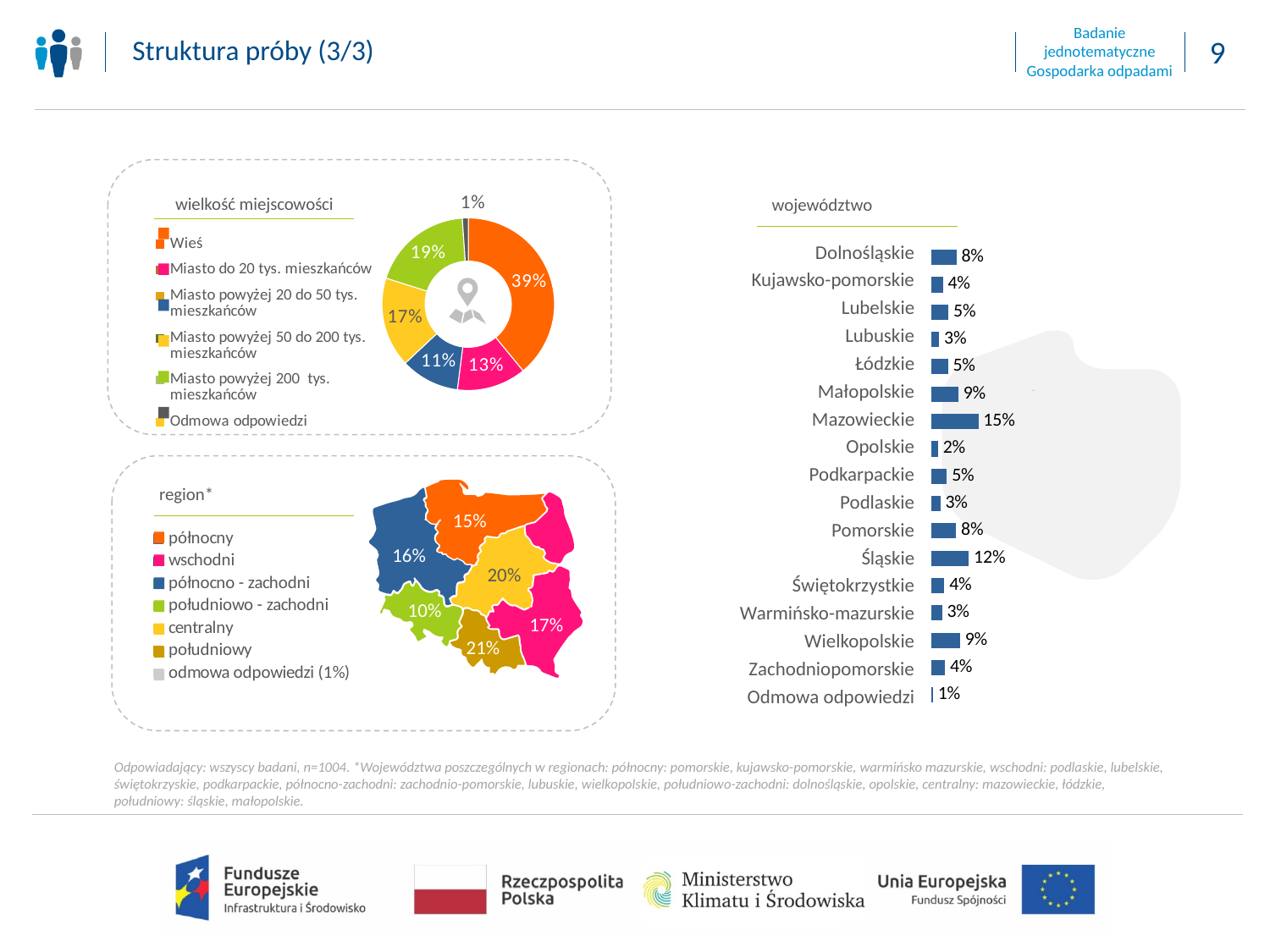
In the 'wielkość miejscowości' donut chart, what share is shown for 'Wieś'? 39% In the 'województwo' bar chart, which voivodeship has the lowest value (excluding 'Odmowa odpowiedzi')? Opolskie In the 'region*' map chart, what share is shown for the 'południowy' region? 21% In the 'województwo' bar chart, what is the value for Mazowieckie? 15% In the 'województwo' bar chart, which is larger: Śląskie or Małopolskie? Śląskie In the 'wielkość miejscowości' donut chart, which category has the largest share? Wieś In the 'województwo' bar chart, what is the difference between Mazowieckie and Śląskie? 3% In the 'wielkość miejscowości' donut chart, what share is shown for 'Miasto powyżej 200 tys. mieszkańców'? 19% What type of chart is the 'województwo' chart? Bar chart In the 'województwo' bar chart, which voivodeship has the highest value? Mazowieckie In the 'wielkość miejscowości' donut chart, what is the difference between the shares for 'Miasto powyżej 50 do 200 tys. mieszkańców' and 'Miasto do 20 tys. mieszkańców'? 4% How many categories are shown in the 'województwo' bar chart? 17